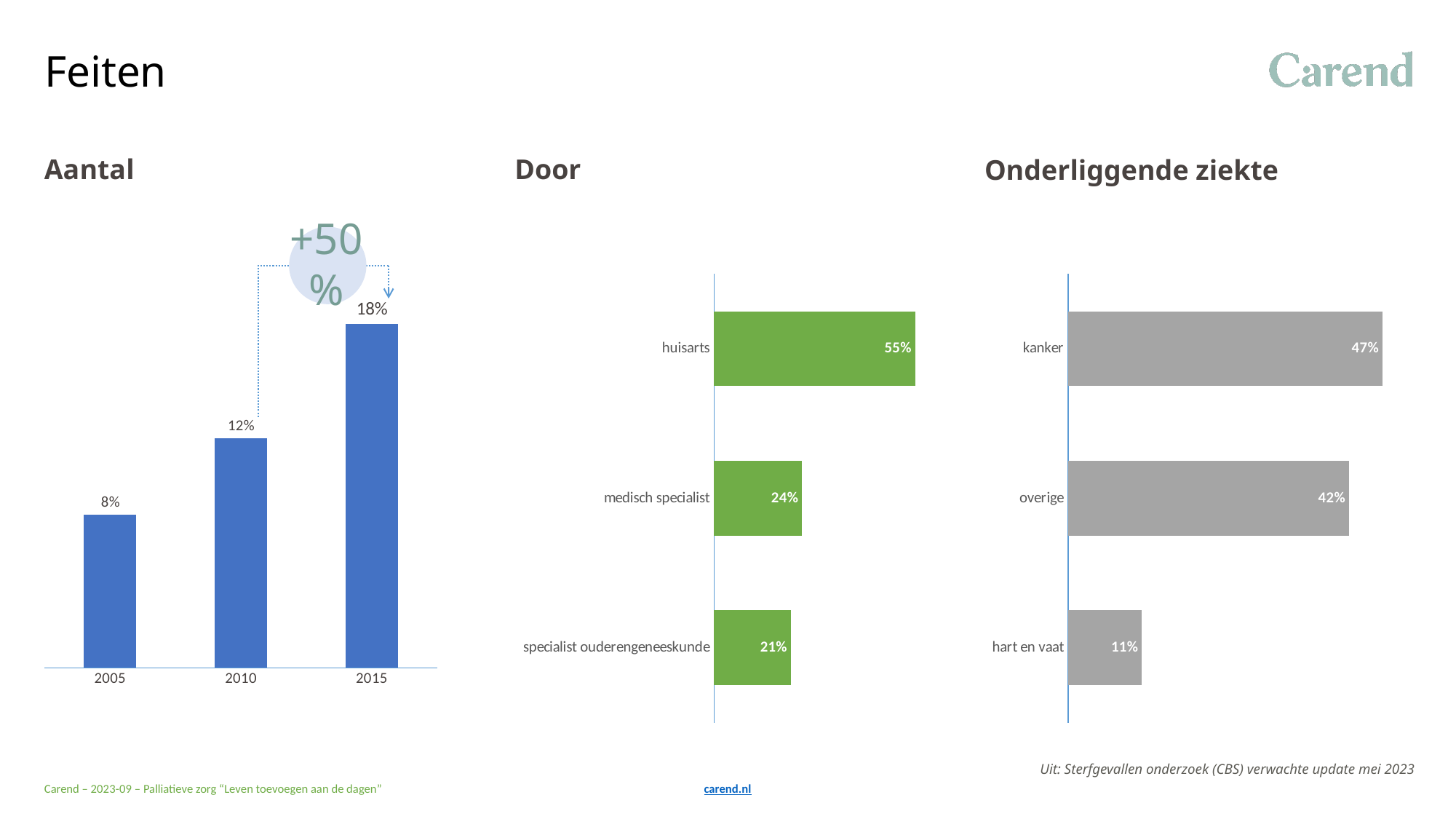
In the 'Door' chart, what is the value for huisarts? 55% In the 'Onderliggende ziekte' chart, what is the value for hart en vaat? 11% In the 'Onderliggende ziekte' chart, which is larger: overige or hart en vaat? overige In the 'Door' chart, what is the difference between huisarts and medisch specialist? 31% In the 'Aantal' chart, do the values rise or fall from 2005 to 2015? rise In the 'Aantal' chart, what is the value for 2005? 8% In the 'Aantal' chart, what is the value for 2015? 18% In the 'Aantal' chart, how many years are shown on the x axis? 3 What kind of chart is the 'Door' chart? bar chart In the 'Aantal' chart, what is the difference between the values for 2015 and 2010? 6% In the 'Onderliggende ziekte' chart, which category has the highest value? kanker In the 'Door' chart, which category has the lowest value? specialist ouderengeneeskunde